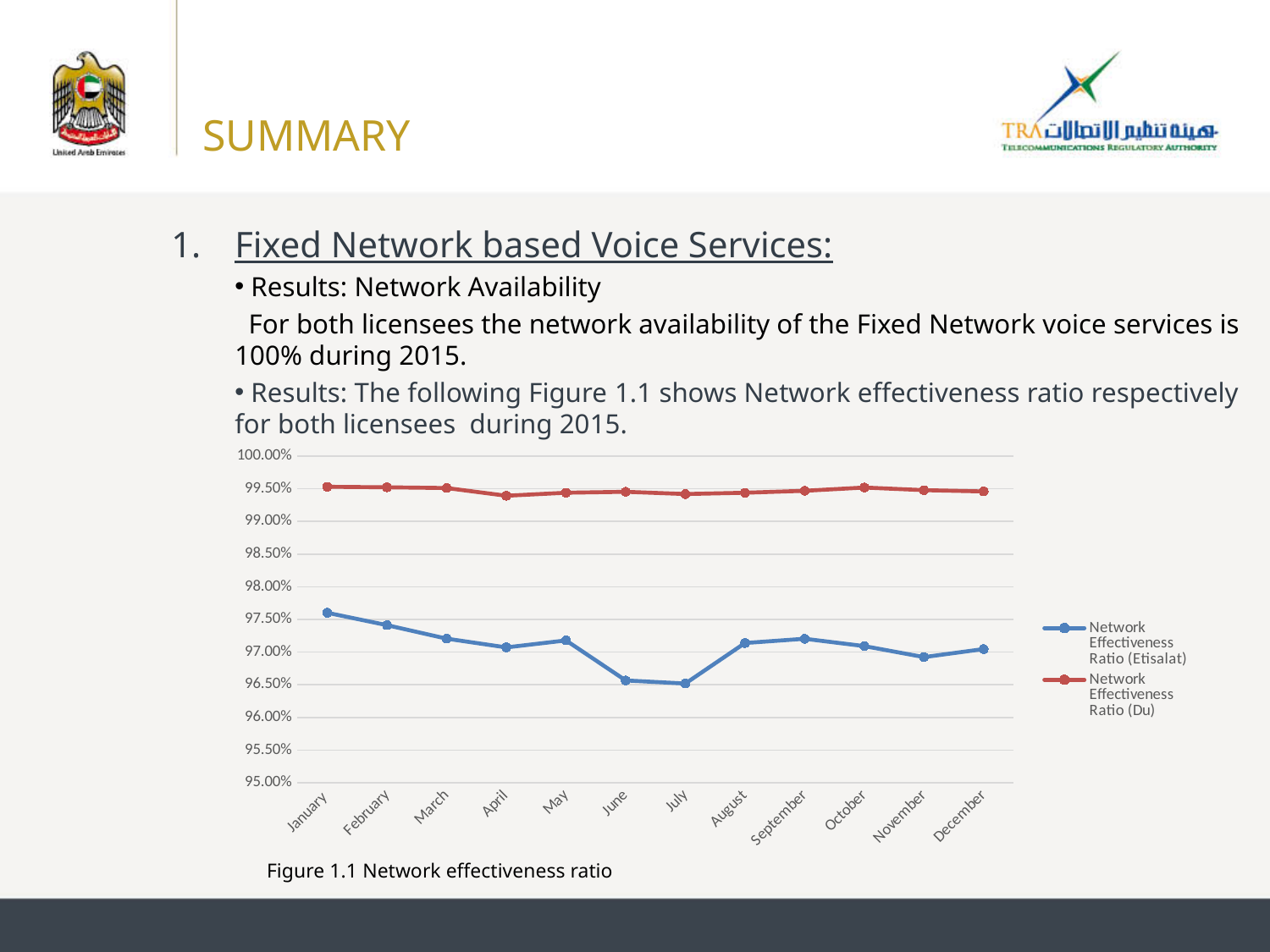
How many months are plotted along the x axis of the chart? 12 Is the Network Effectiveness Ratio (Etisalat) for June greater or less than 97.00%? less What kind of chart is shown in Figure 1.1? Line chart In which month is the Network Effectiveness Ratio (Etisalat) highest? January What is the caption of the figure below the chart? Figure 1.1 Network effectiveness ratio How many series does the legend of the chart list? 2 Is the Network Effectiveness Ratio (Etisalat) for July greater or less than 96.00%? greater Is the Network Effectiveness Ratio (Du) for April greater or less than 99.00%? greater What colour is the line for Network Effectiveness Ratio (Du)? Red Which series has the higher value in June, Network Effectiveness Ratio (Etisalat) or Network Effectiveness Ratio (Du)? Network Effectiveness Ratio (Du) Does the Network Effectiveness Ratio (Etisalat) rise or fall from January to April? fall